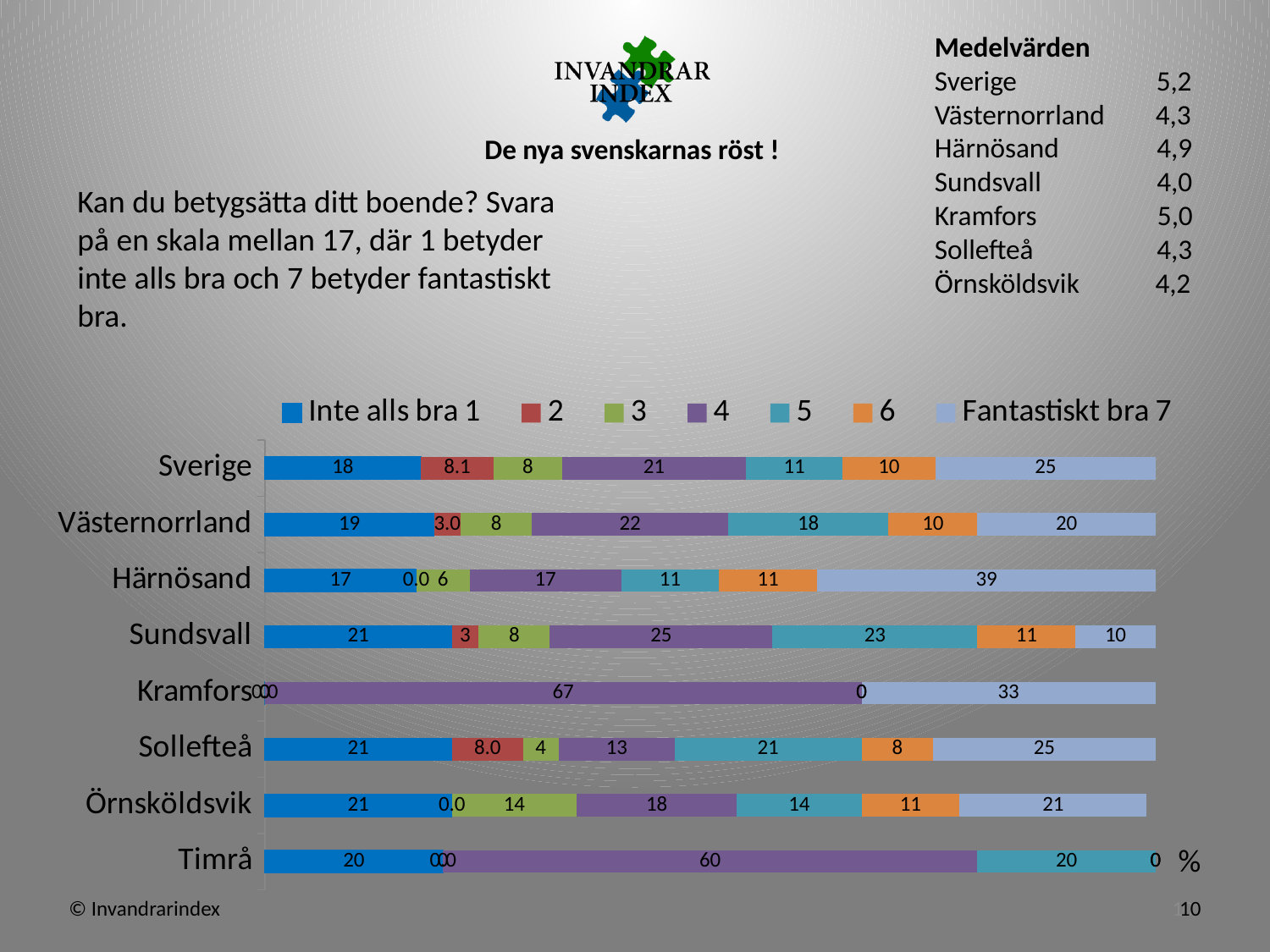
What is the value of the 'Fantastiskt bra 7' segment for Härnösand? 39 Which category has the highest value for 'Fantastiskt bra 7'? Härnösand How many categories (places) are shown on the chart's vertical axis? 8 What kind of chart is shown on the slide? bar chart What is the value of the '3' segment for Örnsköldsvik? 14 What is the value of the '4' segment for Sollefteå? 13 What is the label of the first entry in the chart's legend? Inte alls bra 1 What is the value of the 'Inte alls bra 1' segment for Sverige? 18 How many series does the legend of the chart list? 7 What is the difference between the 'Fantastiskt bra 7' values for Sverige and Sundsvall? 15 Which has the larger value for series '5': Västernorrland or Sverige? Västernorrland What is the value of the '5' segment for Sundsvall? 23